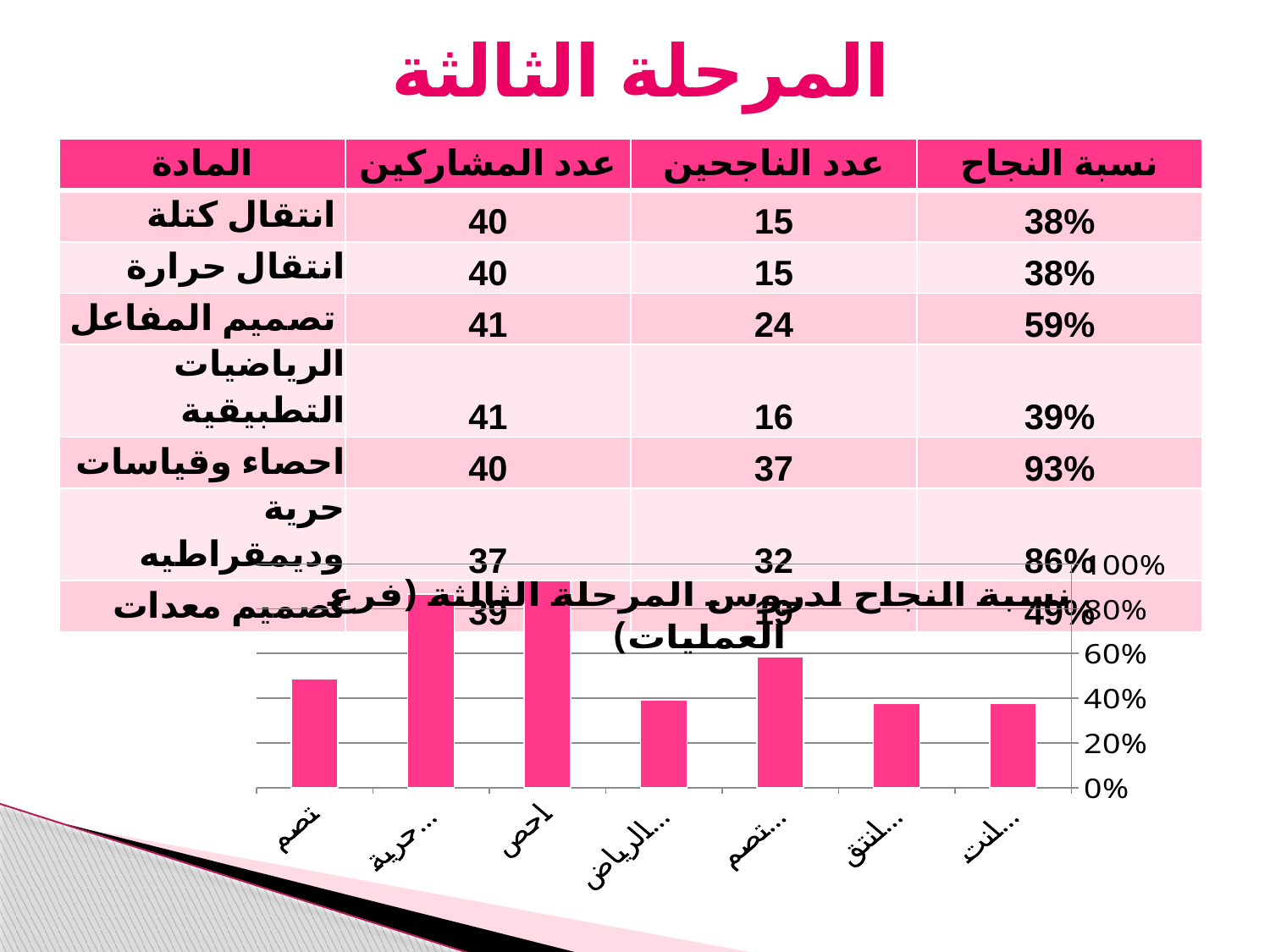
In the chart at the bottom of the slide, which bar is the tallest? the third bar from the left (احص) What kind of chart is shown at the bottom of the slide? bar chart What is the highest tick value shown on the vertical axis of the chart at the bottom of the slide? 100% In the chart at the bottom of the slide, which is taller: the second bar from the left or the fifth bar from the left? the second bar from the left In the chart at the bottom of the slide, is the value of the fourth bar from the left greater or less than 60%? less In the chart at the bottom of the slide, is the value of the first bar from the left greater or less than 60%? less In the chart at the bottom of the slide, is the value of the third bar from the left (labelled احص) greater or less than 80%? greater In the chart at the bottom of the slide, which is taller: the third bar from the left or the fourth bar from the left? the third bar from the left How many bars does the chart at the bottom of the slide have? 7